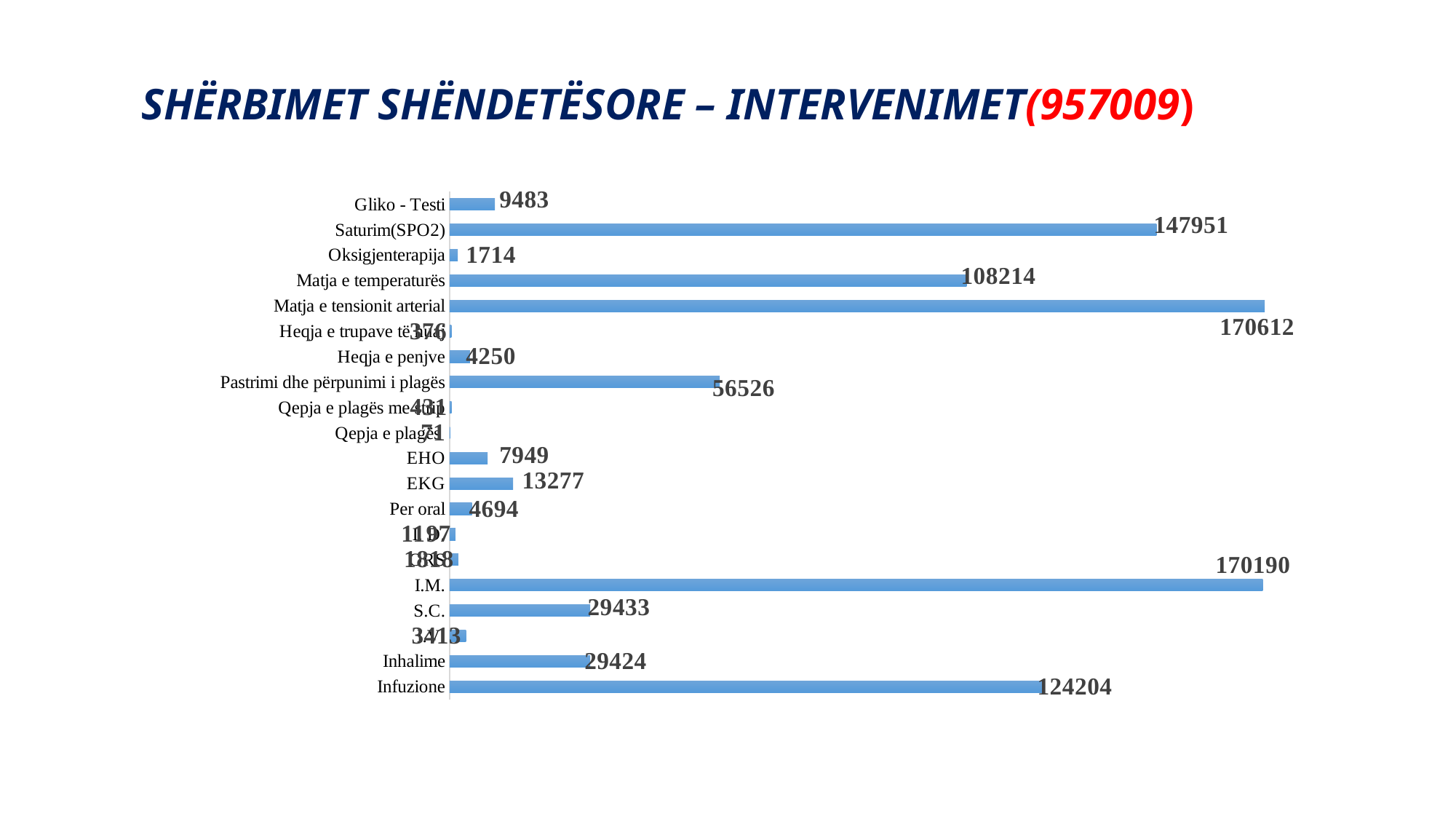
How many bars are plotted in the chart? 20 Which is larger, the value for EKG or the value for EHO? EKG What is the value for Infuzione? 124204 What type of chart is shown on the slide? bar chart What is the value for Oksigjenterapija? 1714 What is the value for Saturim(SPO2)? 147951 Which is larger, the value for Infuzione or the value for Matja e temperaturës? Infuzione What is the value for Pastrimi dhe përpunimi i plagës? 56526 What is the value for Matja e temperaturës? 108214 What number is shown in red in the slide title? 957009 What is the value for EKG? 13277 What is the difference between the values for Saturim(SPO2) and Infuzione? 23747